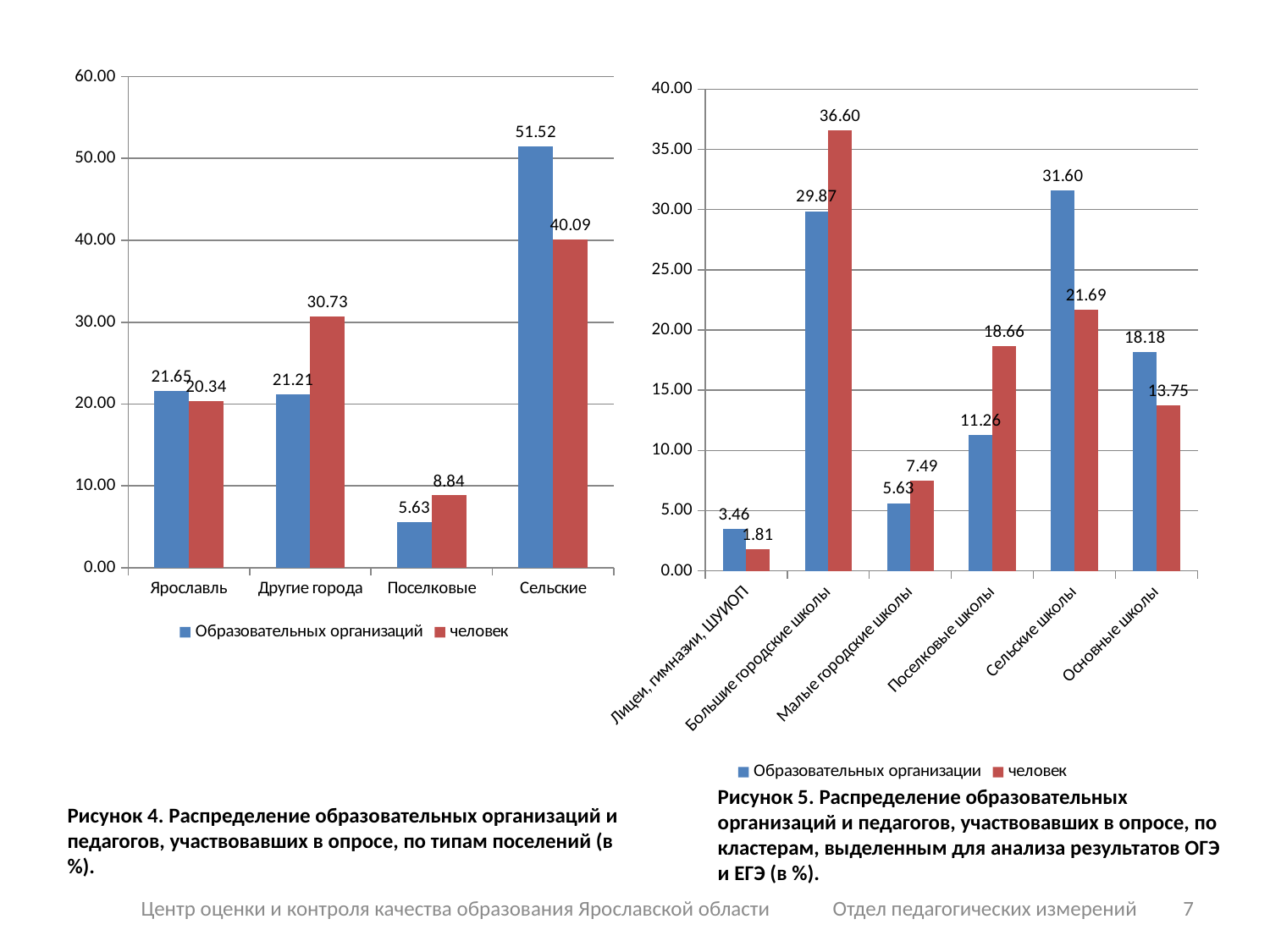
In the right chart (Рисунок 5), which category has the lowest value in the series человек? Лицеи, гимназии, ШУИОП In the right chart (Рисунок 5), how many series does the legend list? 2 In the right chart (Рисунок 5), what is the value for Большие городские школы in the series человек? 36.60 In the right chart (Рисунок 5), which category has the highest value in the series Образовательных организации? Сельские школы What type of chart is the right chart (Рисунок 5)? Bar chart In the left chart (Рисунок 4), what is the value for Сельские in the series Образовательных организаций? 51.52 In the left chart (Рисунок 4), what is the difference between the two series for Сельские? 11.43 In the left chart (Рисунок 4), which is larger for Ярославль: Образовательных организаций or человек? Образовательных организаций In the left chart (Рисунок 4), which category has the lowest value in the series человек? Поселковые In the right chart (Рисунок 5), what is the difference between the two series for Поселковые школы? 7.40 In the left chart (Рисунок 4), what is the value for Другие города in the series человек? 30.73 In the left chart (Рисунок 4), how many categories are shown on the x axis? 4